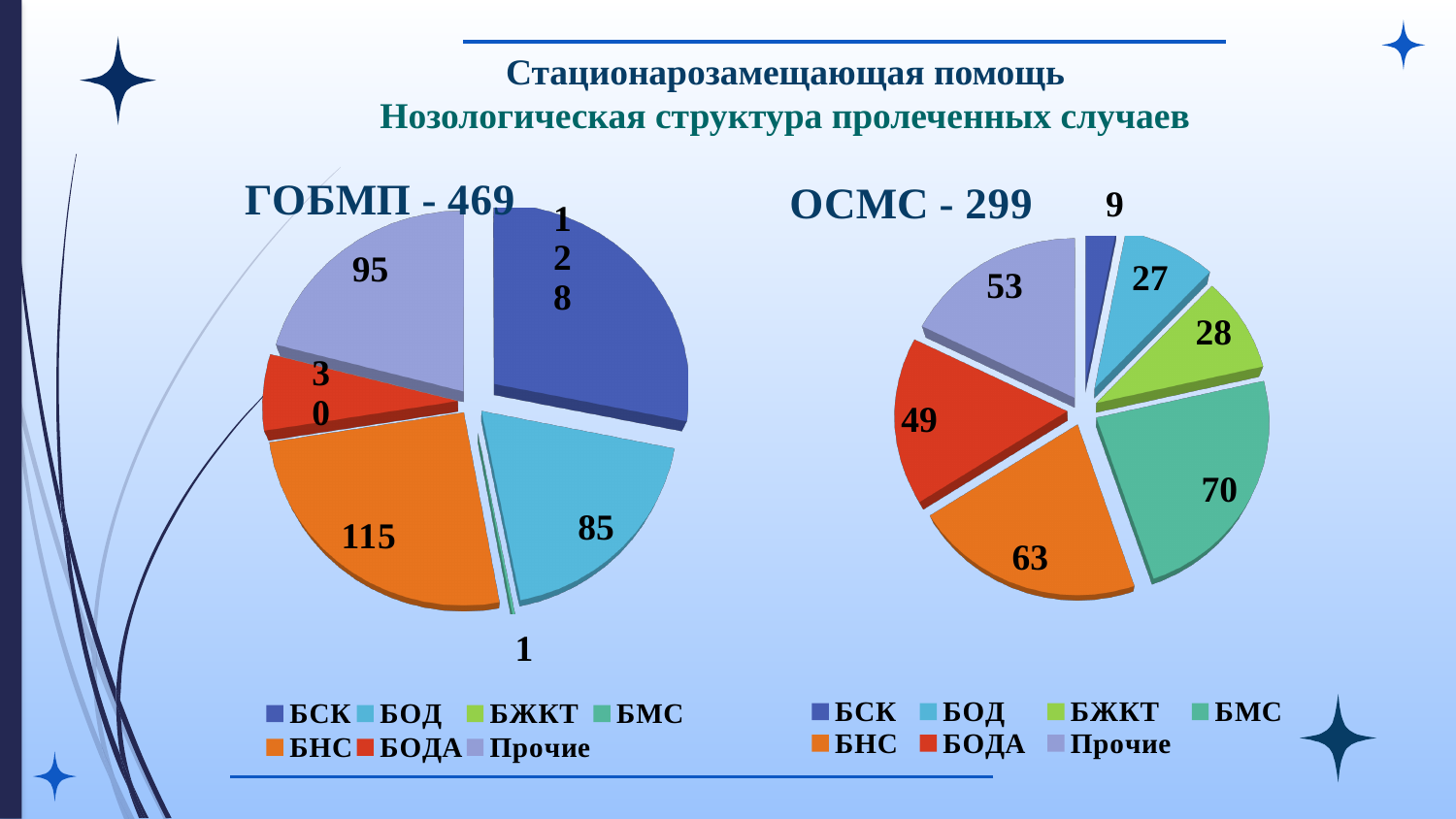
In the ГОБМП - 469 pie chart, which category has the largest slice? БСК How many categories does the legend of the ОСМС - 299 pie chart list? 7 In the ГОБМП - 469 pie chart, what is the value for БОДА? 30 In the ОСМС - 299 pie chart, what is the value for БМС? 70 In the ОСМС - 299 pie chart, what is the difference between the values for БНС and БОДА? 14 In the ОСМС - 299 pie chart, which category has the smallest slice? БСК In the ОСМС - 299 pie chart, what is the difference between the values for БМС and БОД? 43 In the ОСМС - 299 pie chart, what is the value for Прочие? 53 In the ГОБМП - 469 pie chart, which is larger, БОД or Прочие? Прочие In the ГОБМП - 469 pie chart, what is the value for БНС? 115 What type of chart is used on this slide? Pie chart In the ОСМС - 299 pie chart, which category has the largest slice? БМС